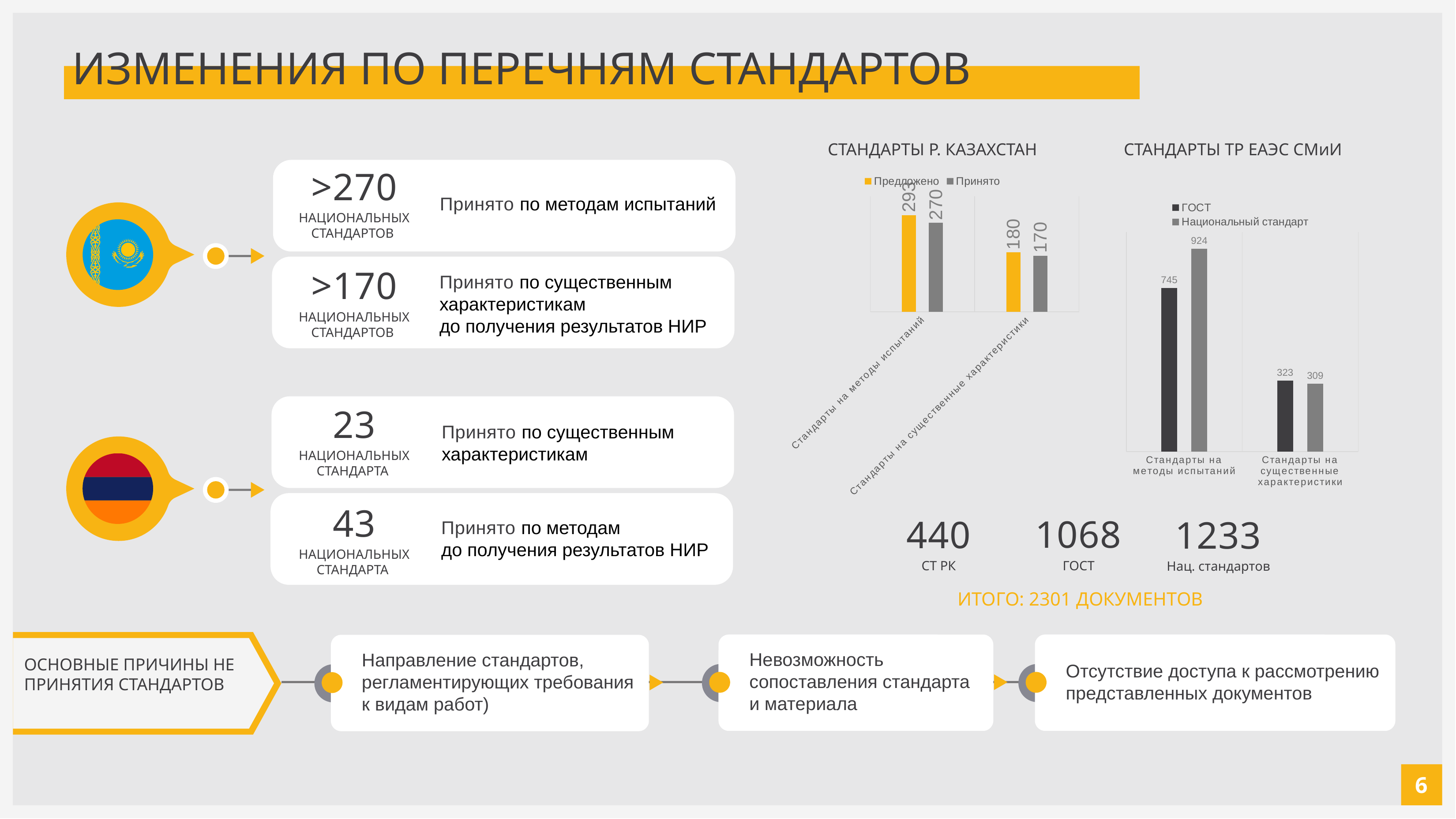
In the chart titled 'СТАНДАРТЫ ТР ЕАЭС СМиИ', what is the value of 'Национальный стандарт' for 'Стандарты на существенные характеристики'? 309 In the chart titled 'СТАНДАРТЫ ТР ЕАЭС СМиИ', what is the difference between 'Национальный стандарт' and 'ГОСТ' for 'Стандарты на методы испытаний'? 179 In the chart titled 'СТАНДАРТЫ ТР ЕАЭС СМиИ', what is the value of 'ГОСТ' for 'Стандарты на методы испытаний'? 745 In the chart titled 'СТАНДАРТЫ ТР ЕАЭС СМиИ', how many categories are shown on the x axis? 2 In the chart titled 'СТАНДАРТЫ Р. КАЗАХСТАН', what is the difference between 'Предложено' and 'Принято' for 'Стандарты на методы испытаний'? 23 In the chart titled 'СТАНДАРТЫ Р. КАЗАХСТАН', what is the value of 'Предложено' for 'Стандарты на методы испытаний'? 293 In the chart titled 'СТАНДАРТЫ ТР ЕАЭС СМиИ', what are the two series listed in the legend? ГОСТ and Национальный стандарт What kind of chart is the one titled 'СТАНДАРТЫ ТР ЕАЭС СМиИ'? Bar chart In the chart titled 'СТАНДАРТЫ Р. КАЗАХСТАН', which category has the higher 'Предложено' value? Стандарты на методы испытаний In the chart titled 'СТАНДАРТЫ ТР ЕАЭС СМиИ', which is larger for 'Стандарты на методы испытаний': 'ГОСТ' or 'Национальный стандарт'? Национальный стандарт In the chart titled 'СТАНДАРТЫ Р. КАЗАХСТАН', what is the value of 'Принято' for 'Стандарты на существенные характеристики'? 170 In the chart titled 'СТАНДАРТЫ Р. КАЗАХСТАН', how many series does the legend list? 2